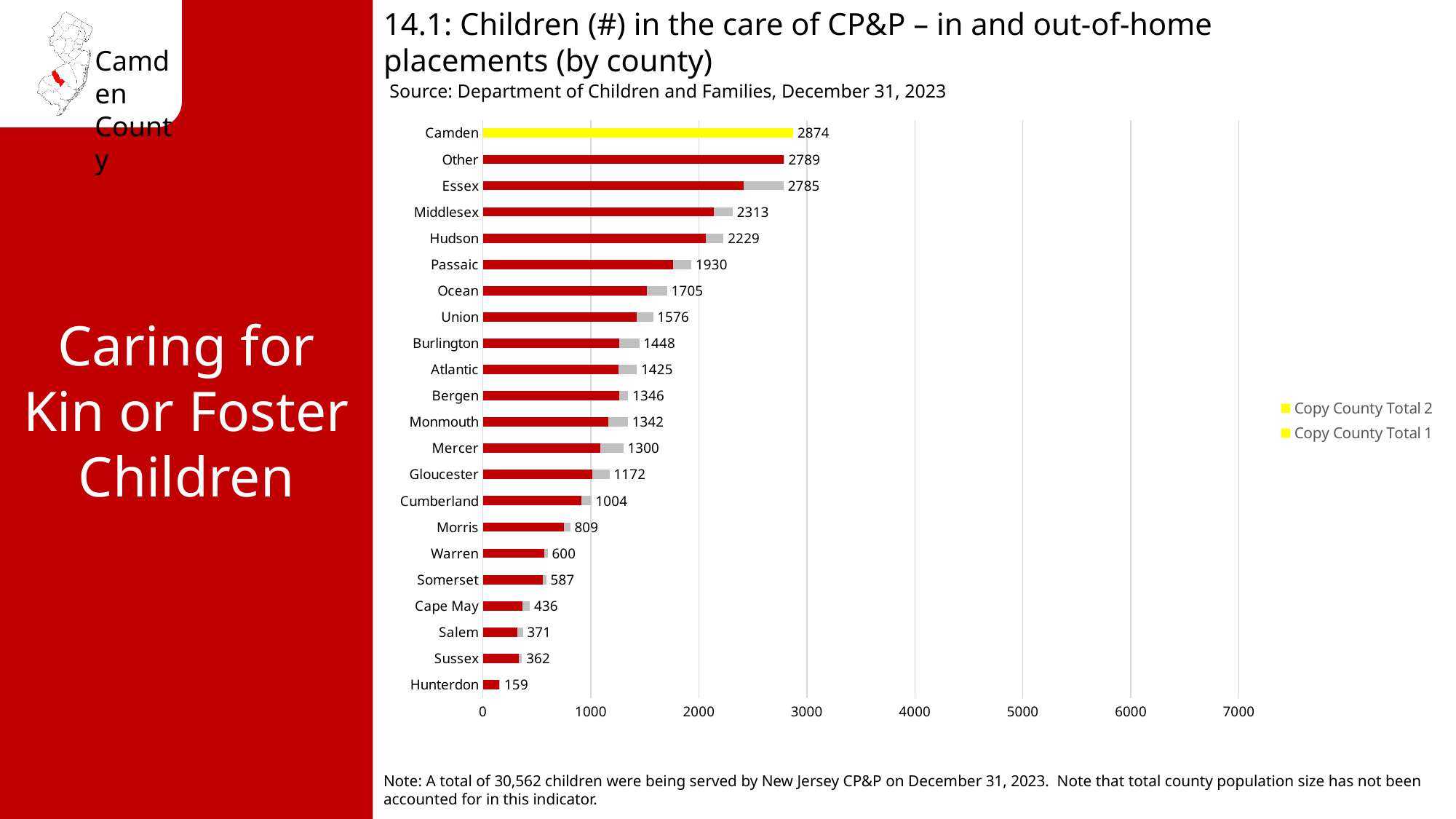
What is the total number of children in the care of CP&P for Camden? 2874 What is the total value shown for Hudson? 2229 What kind of chart is shown on the slide? Bar chart Which county has the lowest total number of children in the care of CP&P? Hunterdon What is the total value shown for Cumberland? 1004 What is the difference between the totals for Morris and Warren? 209 Is the total value for Middlesex greater or less than 2000? greater How many series does the legend list? 2 Which county has the highest total number of children in the care of CP&P? Camden Which has a larger total, Passaic or Ocean? Passaic How many counties/categories are shown on the chart? 22 What is the difference between the totals for Camden and Essex? 89